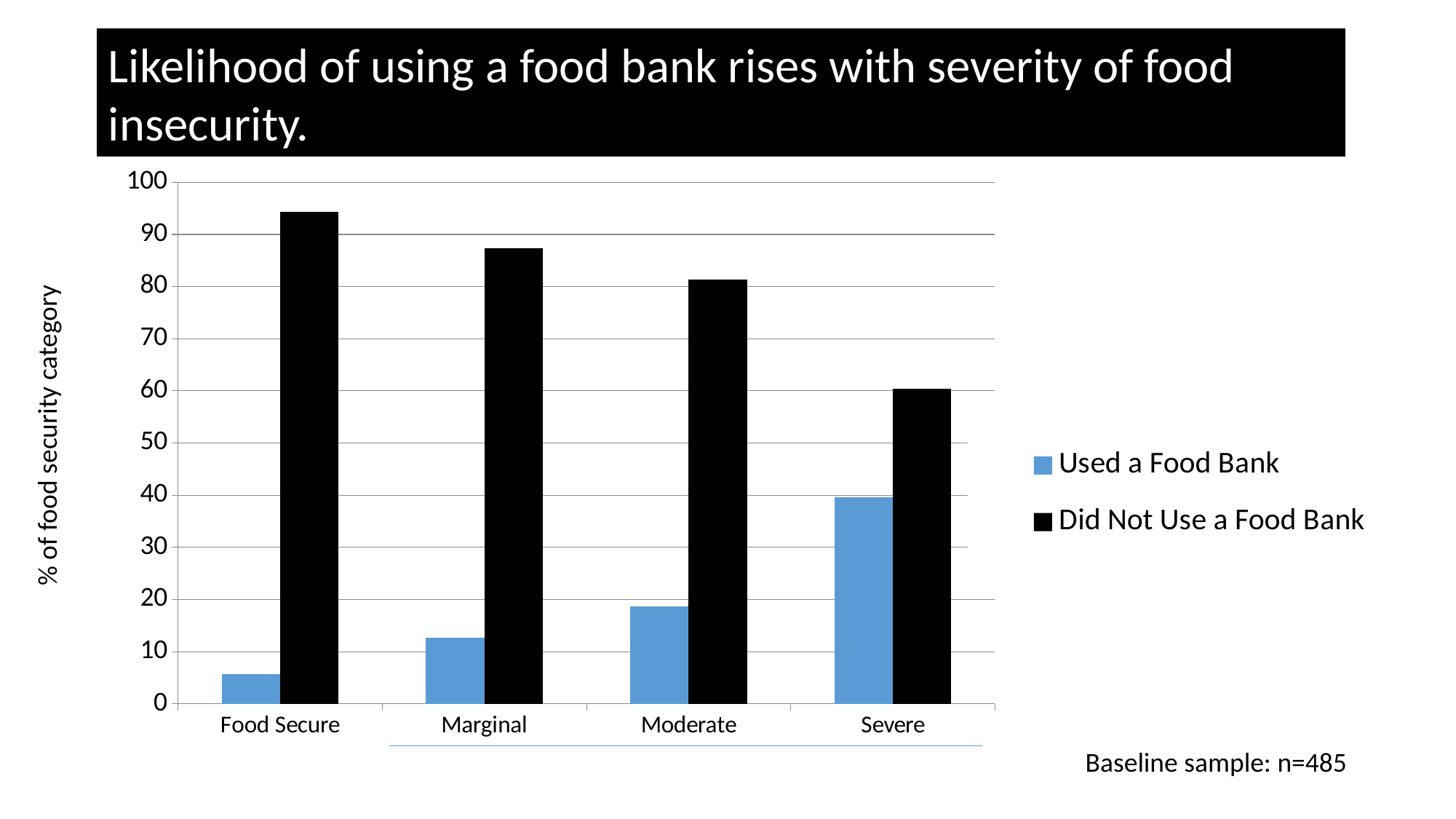
What is the label of the y axis? % of food security category What kind of chart is shown on the slide? bar chart Which category has the lowest value for Used a Food Bank? Food Secure Does the value for Used a Food Bank rise or fall from Food Secure to Severe? rise Which category has the highest value for Used a Food Bank? Severe Is the value for Used a Food Bank in the Food Secure category greater or less than 10? less Which is larger in the Moderate category: Used a Food Bank or Did Not Use a Food Bank? Did Not Use a Food Bank Is the value for Used a Food Bank in the Severe category greater or less than 30? greater Which category has the lowest value for Did Not Use a Food Bank? Severe How many series does the legend list? 2 How many food security categories are shown on the x axis? 4 Is the value for Did Not Use a Food Bank in the Food Secure category greater or less than 90? greater